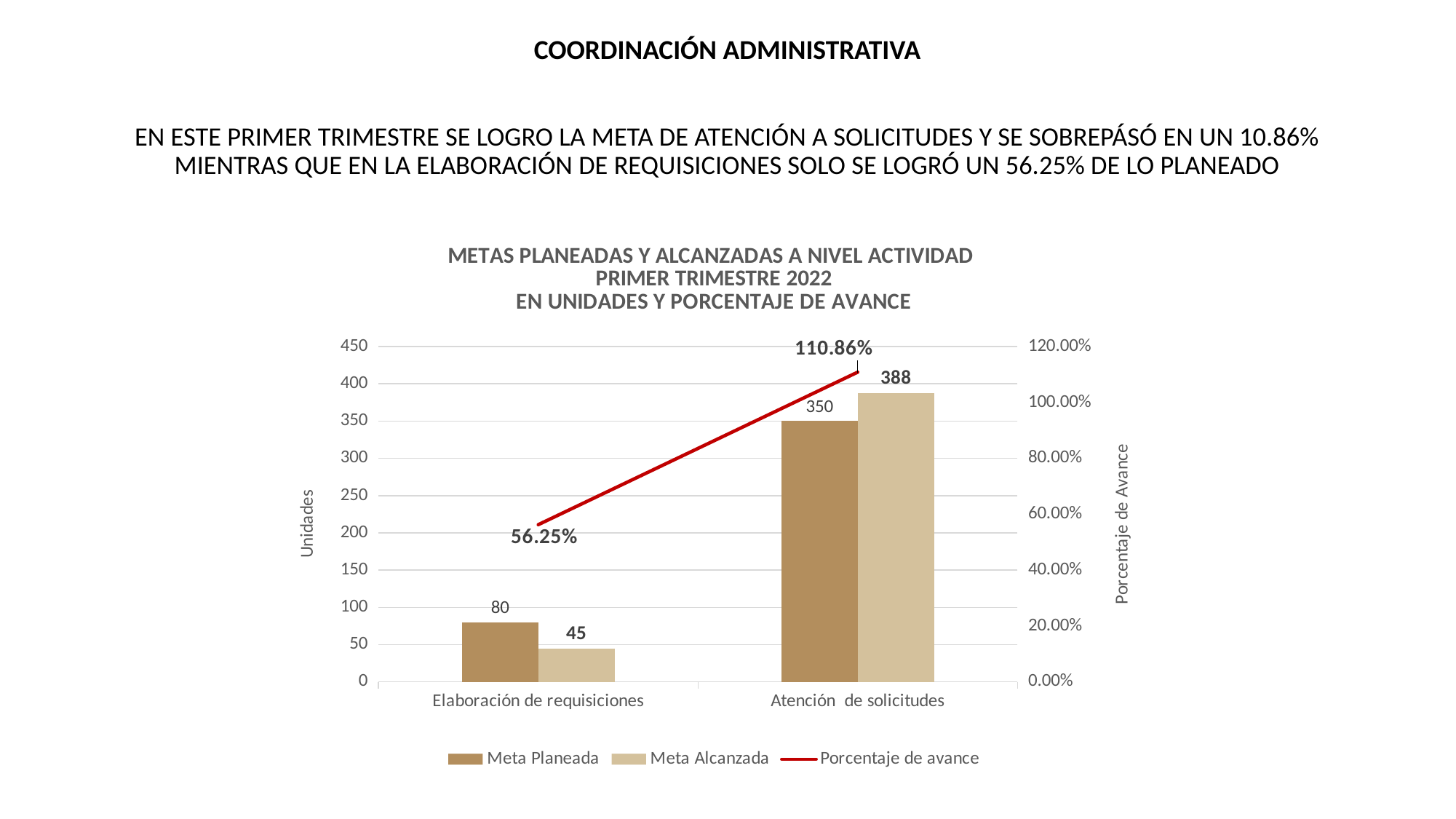
How many series does the legend list? 3 For Elaboración de requisiciones, which is larger: Meta Planeada or Meta Alcanzada? Meta Planeada What is the Meta Alcanzada value for Atención de solicitudes? 388 What is the Porcentaje de avance for Elaboración de requisiciones? 56.25% What is the label of the right-hand vertical axis? Porcentaje de Avance What is the Meta Planeada value for Elaboración de requisiciones? 80 What is the difference between Meta Alcanzada and Meta Planeada for Atención de solicitudes? 38 How many categories are shown on the x axis? 2 Which category has the lowest Meta Planeada value? Elaboración de requisiciones What kind of chart is this? Combined bar and line chart What is the Porcentaje de avance for Atención de solicitudes? 110.86% Which category has the highest Meta Alcanzada value? Atención de solicitudes